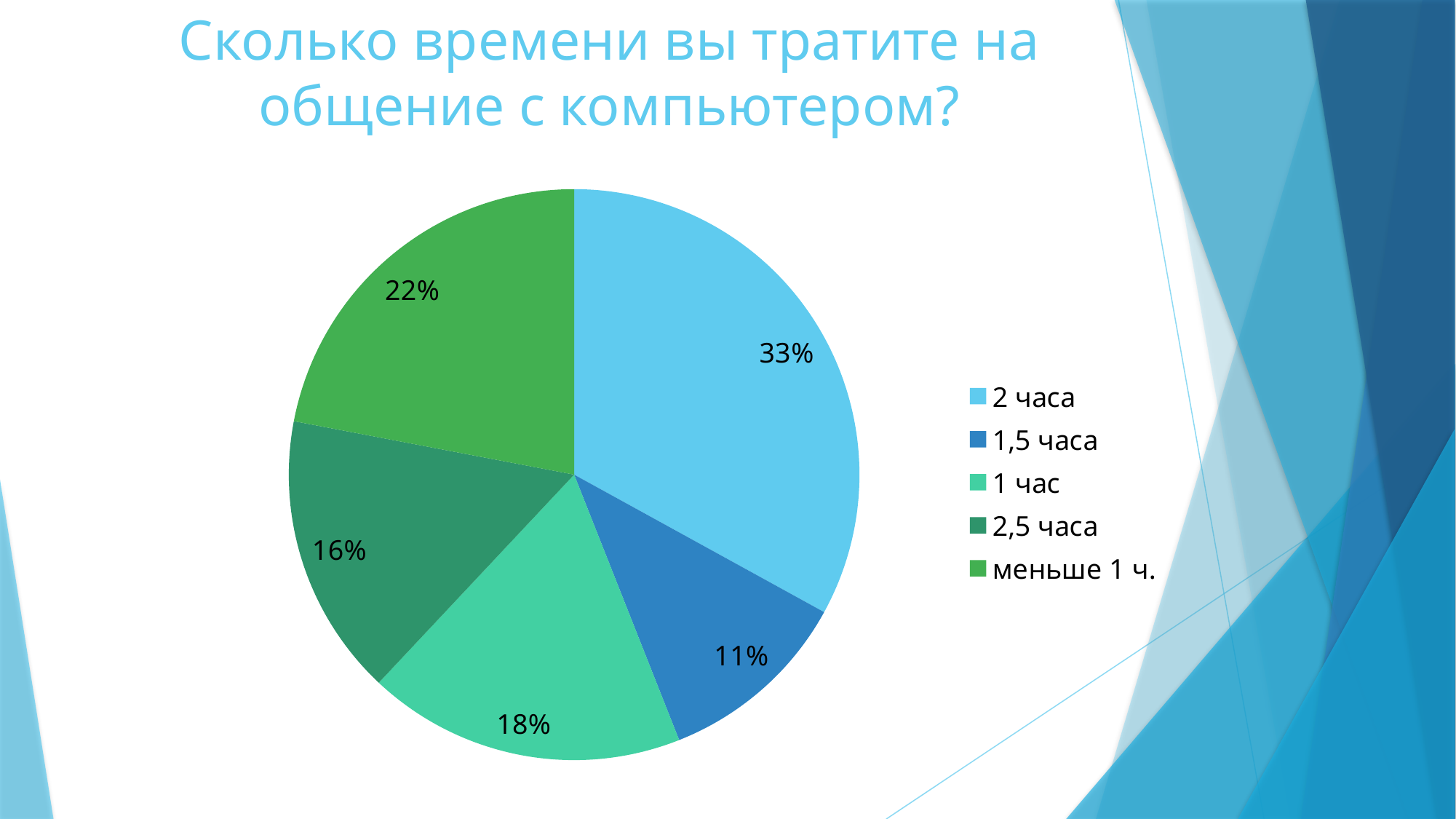
What share of the pie does the "2 часа" slice represent? 33% Which category has the smallest slice of the pie? 1,5 часа What is the value shown for "1,5 часа"? 11% What kind of chart is shown on the slide? Pie chart What is the value shown for "2,5 часа"? 16% What is the value shown for "1 час"? 18% What is the value shown for "меньше 1 ч."? 22% How many categories does the pie chart have? 5 What is the title of the chart on the slide? Сколько времени вы тратите на общение с компьютером? What is the difference between the "2 часа" and "меньше 1 ч." shares? 11% Which is larger, the share for "1 час" or the share for "2,5 часа"? 1 час Which category has the largest slice of the pie? 2 часа